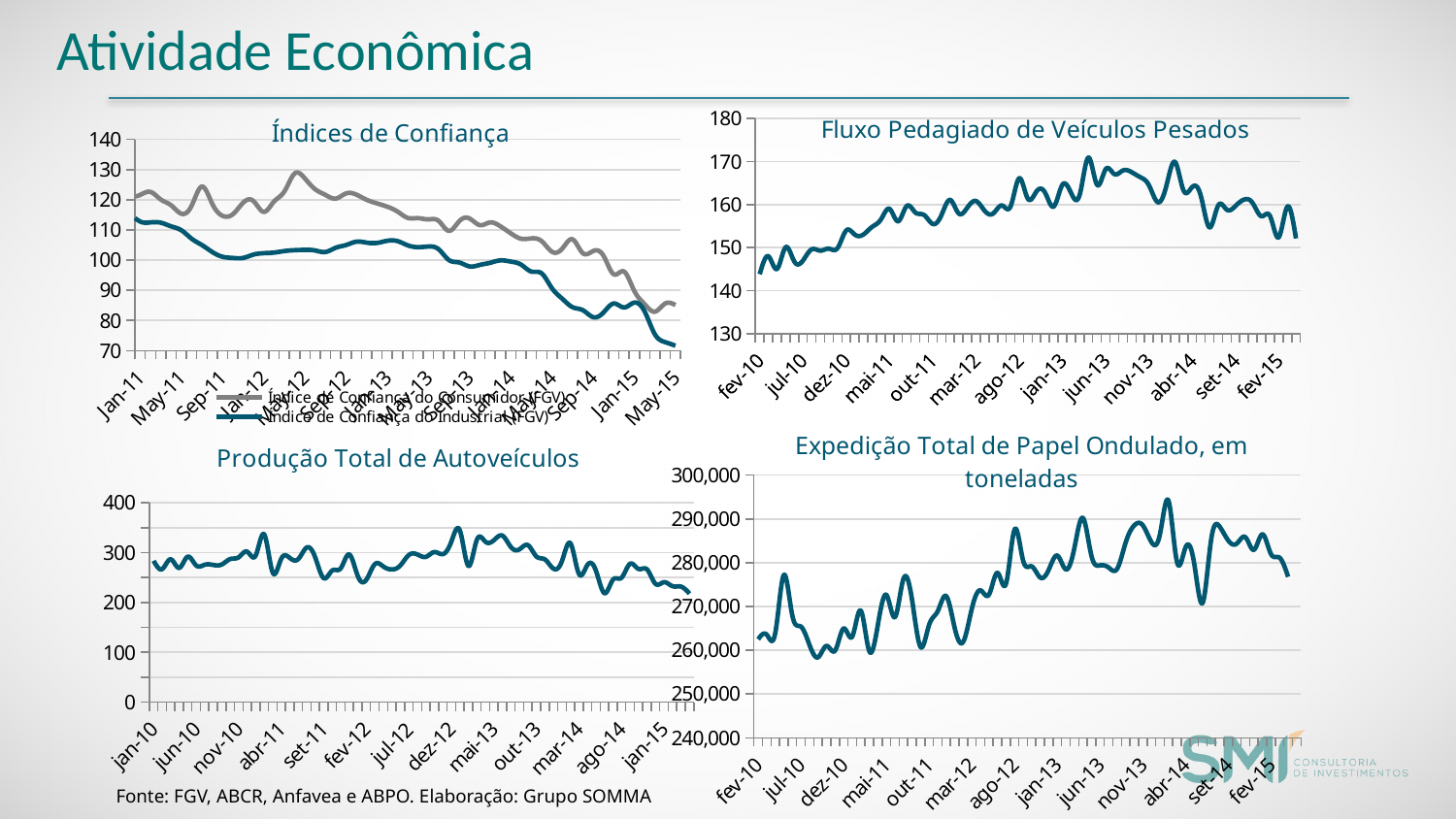
In the 'Índices de Confiança' chart, is the value of the Índice de Confiança da Indústria (FGV) at May-15 greater or less than 80? less In the 'Expedição Total de Papel Ondulado, em toneladas' chart, is the highest value reached greater or less than 290,000? greater How many series does the legend of the 'Índices de Confiança' chart list? 2 In the 'Fluxo Pedagiado de Veículos Pesados' chart, is the highest value reached greater or less than 160? greater What kind of chart is the 'Índices de Confiança' chart? line chart How many charts are shown on the slide? 4 In the 'Índices de Confiança' chart, which series is drawn in gray? Índice de Confiança do Consumidor (FGV) What kind of chart is 'Produção Total de Autoveículos'? line chart In the 'Índices de Confiança' chart, do the values of the Índice de Confiança do Consumidor (FGV) rise or fall overall from Jan-11 to May-15? fall